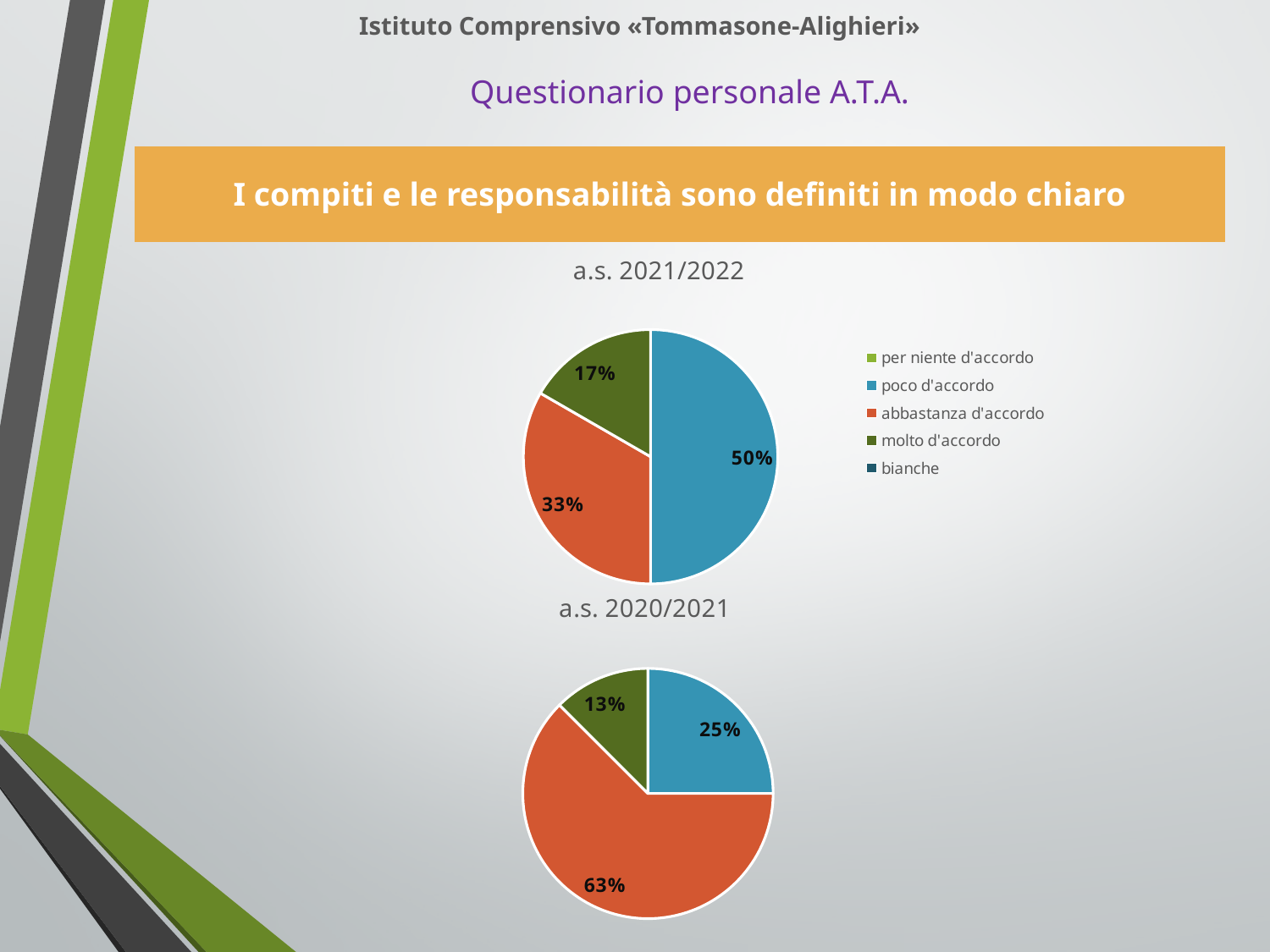
In the a.s. 2021/2022 chart, which category has the largest slice? poco d'accordo What type of chart is used for a.s. 2021/2022? pie chart In the a.s. 2020/2021 chart, what share is labelled for the 'molto d'accordo' slice? 13% In the a.s. 2021/2022 chart, what share is labelled for the 'molto d'accordo' slice? 17% In the a.s. 2021/2022 chart, what share is labelled for the 'poco d'accordo' slice? 50% In the a.s. 2020/2021 chart, what share is labelled for the 'abbastanza d'accordo' slice? 63% In the a.s. 2021/2022 chart, what share is labelled for the 'abbastanza d'accordo' slice? 33% In the a.s. 2021/2022 chart, which is larger: 'abbastanza d'accordo' or 'molto d'accordo'? abbastanza d'accordo In the a.s. 2020/2021 chart, which category has the smallest slice? molto d'accordo In the a.s. 2020/2021 chart, what share is labelled for the 'poco d'accordo' slice? 25% In the a.s. 2020/2021 chart, what is the difference between the 'abbastanza d'accordo' and 'poco d'accordo' shares? 38% How many entries does the legend list? 5